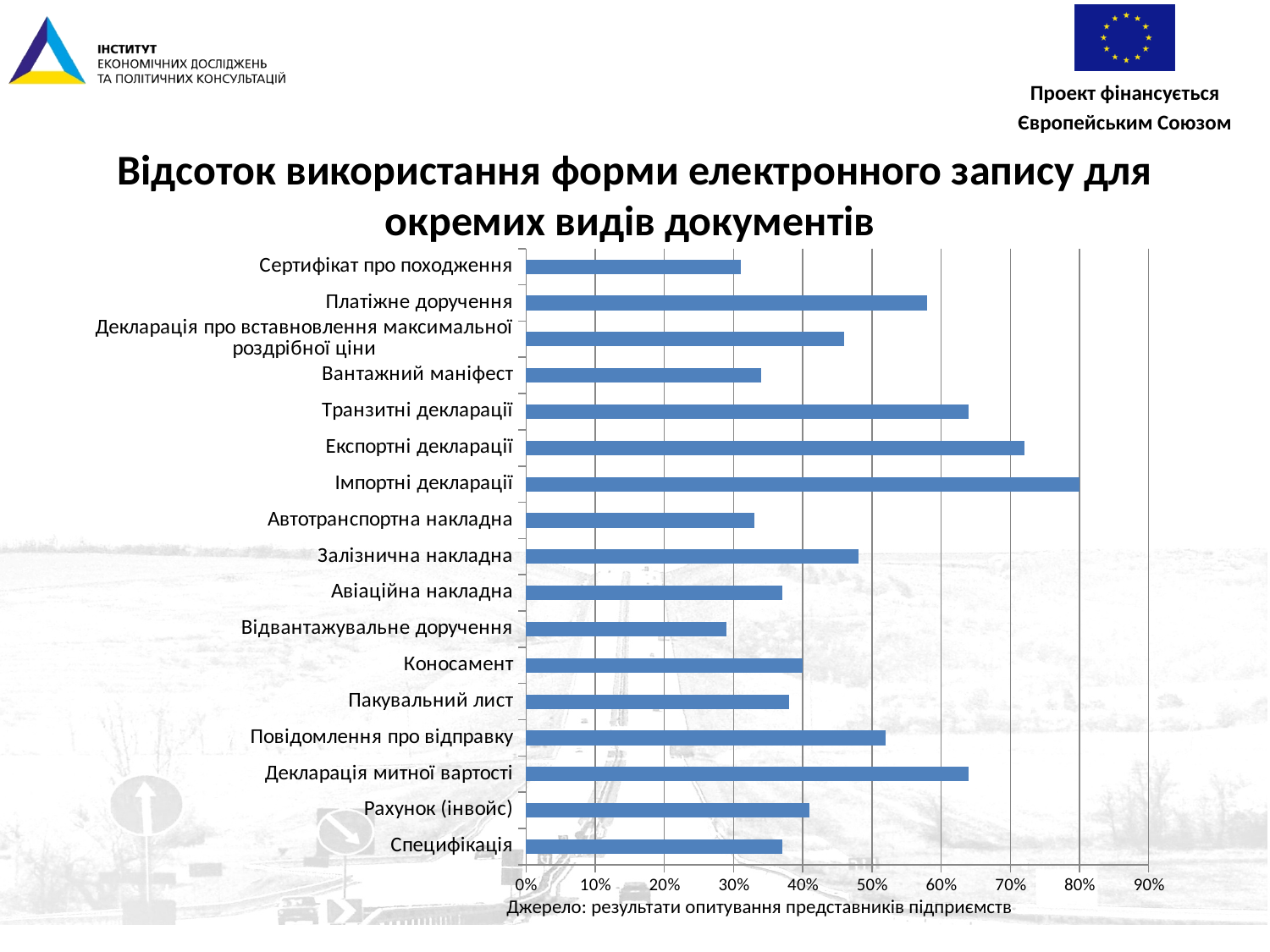
What is the title of the chart? Відсоток використання форми електронного запису для окремих видів документів What kind of chart is shown on the slide? bar chart How many document types (categories) are shown in the chart? 17 Is the value for Вантажний маніфест greater or less than 40%? less Is the value for Експортні декларації greater or less than 60%? greater Which document type has the highest percentage of electronic form use? Імпортні декларації Is the value for Залізнична накладна greater or less than 40%? greater Which is larger: the value for Платіжне доручення or for Сертифікат про походження? Платіжне доручення What source is given below the chart? результати опитування представників підприємств Which is larger: the value for Експортні декларації or for Транзитні декларації? Експортні декларації